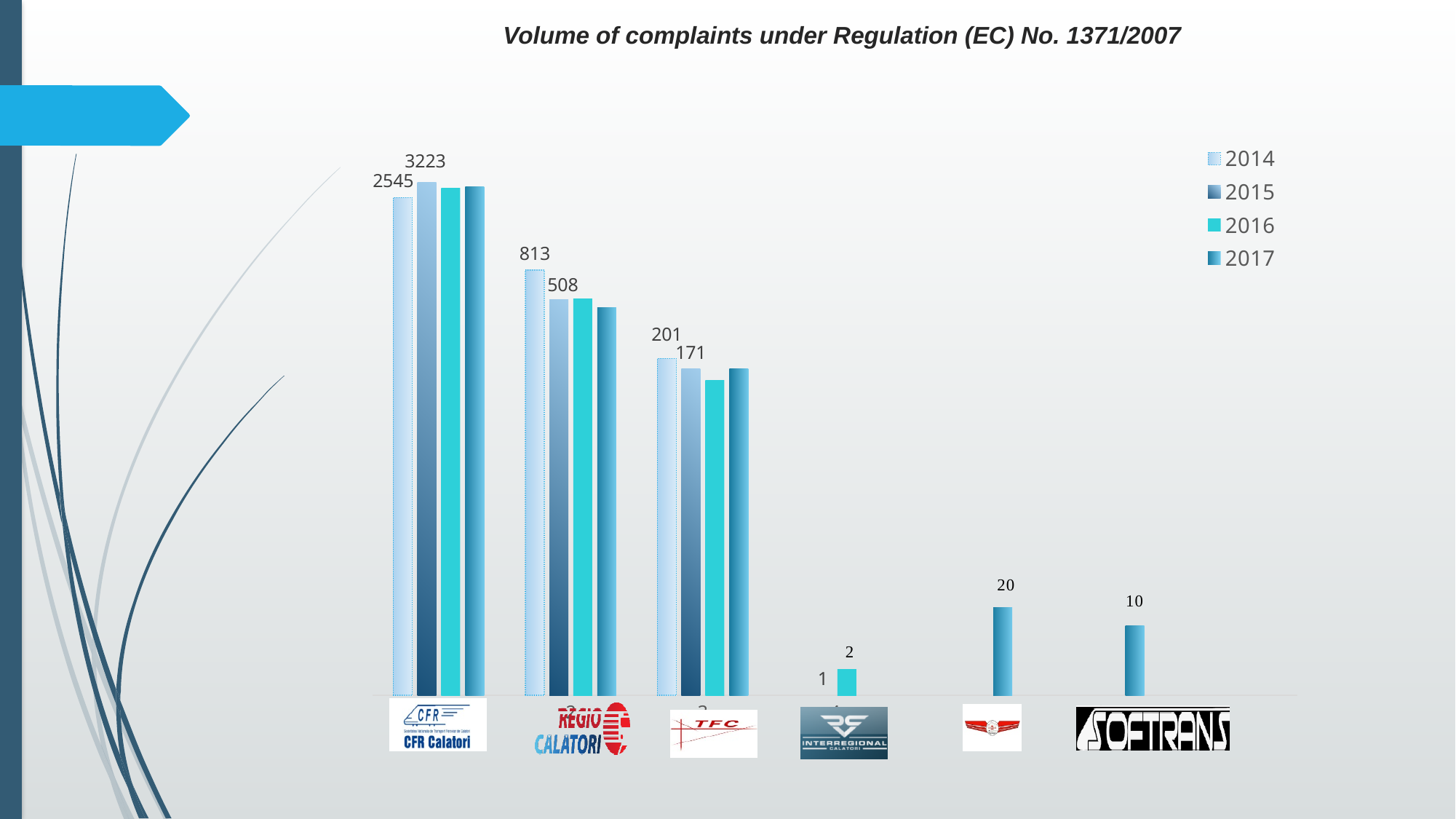
Which is larger for Regio Calatori, the 2014 value or the 2015 value? 2014 What is the value for CFR Calatori in 2014? 2545 What is the value for Regio Calatori in 2014? 813 How many series does the legend list? 4 Which operator has the highest volume of complaints? CFR Calatori What is the value for CFR Calatori in 2015? 3223 What is the value for Regio Calatori in 2015? 508 What kind of chart is shown on the slide? Bar chart What is the difference between the 2015 and 2014 values for CFR Calatori? 678 What is the value for TFC in 2014? 201 What is the value for Softrans in 2017? 10 What is the title of the chart? Volume of complaints under Regulation (EC) No. 1371/2007